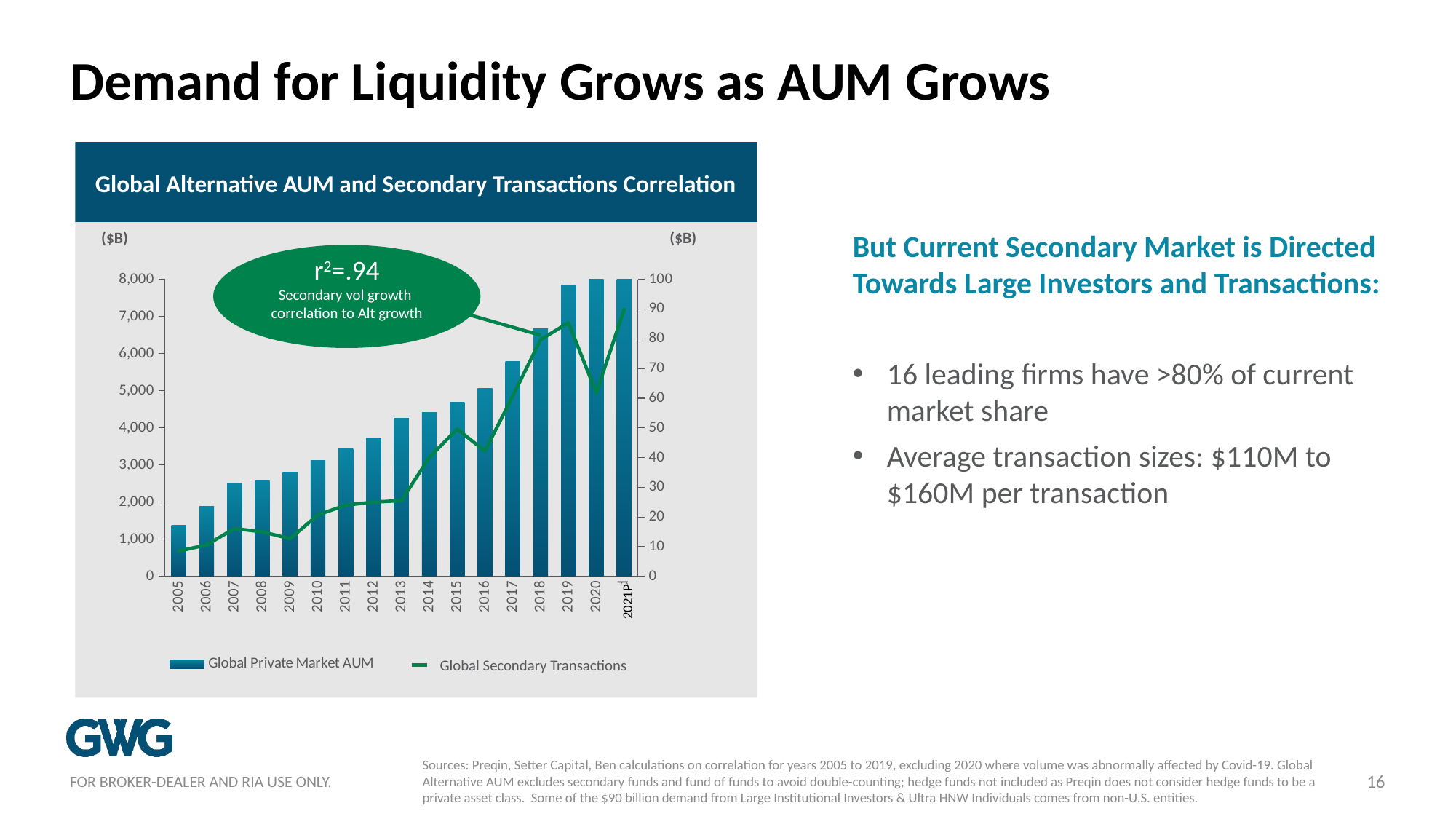
Do the Global Private Market AUM bars generally rise or fall from 2005 to 2021P? Rise How many series does the chart's legend list? 2 Is the Global Secondary Transactions value for 2020 greater or less than 70? less Which year has the lowest value on the Global Secondary Transactions line? 2005 What kind of chart is shown on the slide? A combined bar and line chart Is the Global Private Market AUM value for 2017 greater or less than 6,000? less Which year has the larger Global Secondary Transactions value, 2019 or 2020? 2019 How many years are shown along the x axis of the chart? 17 Which year has the larger Global Private Market AUM bar, 2010 or 2015? 2015 What r-squared value is shown in the green oval on the chart? r²=.94 Is the Global Private Market AUM value for 2019 greater or less than 7,000? greater Which year has the lowest Global Private Market AUM bar? 2005